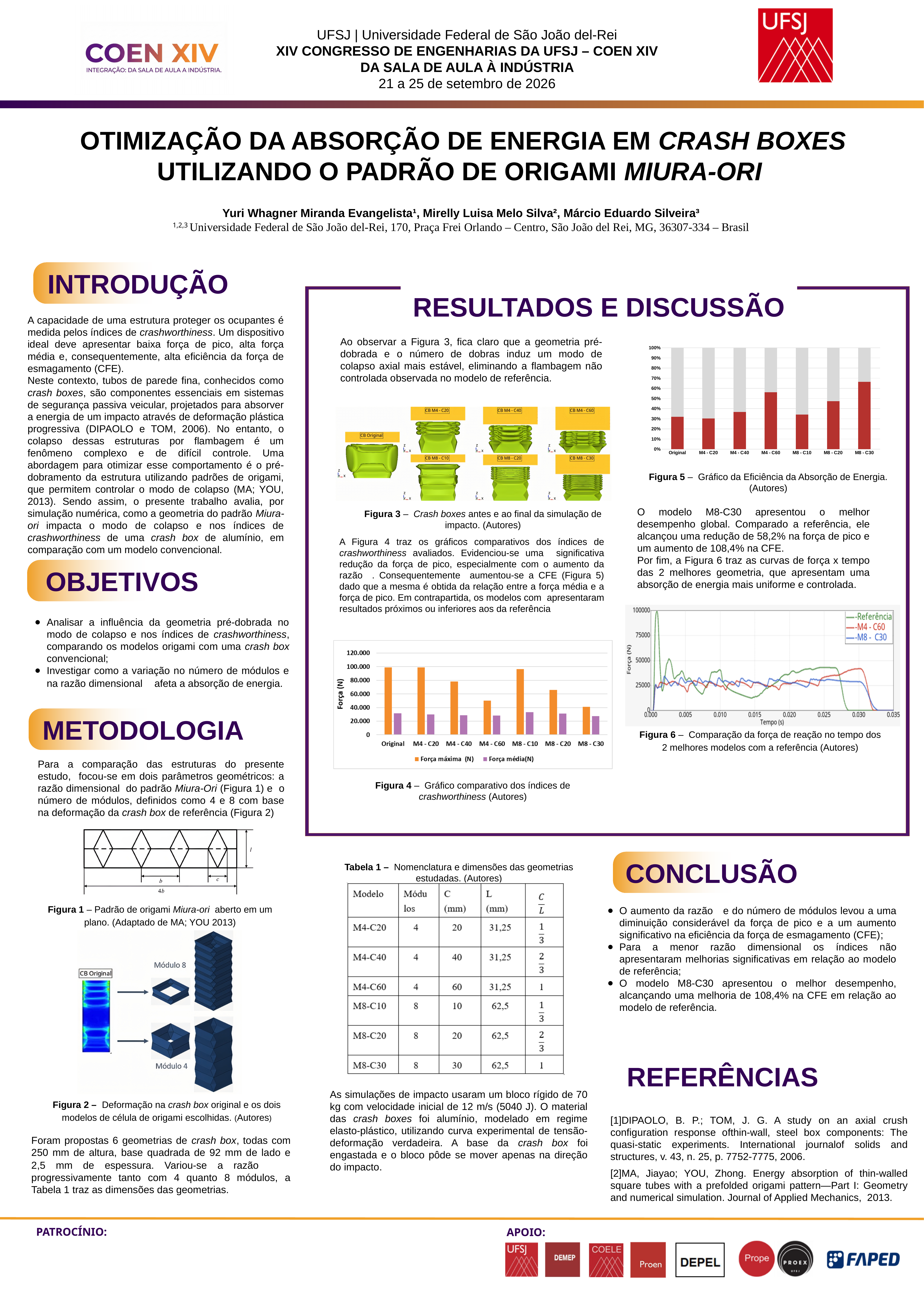
In Figura 5, is the red bar value for M8 - C30 greater or less than 60%? greater In Figura 4, how many series does the legend list? 2 In Figura 4, how many model categories are shown on the x axis? 7 In Figura 6 (Comparação da força de reação no tempo), how many series does the legend list? 3 In Figura 5, is the red bar value for M4 - C60 greater or less than 50%? greater In Figura 5 (Gráfico da Eficiência da Absorção de Energia), which model has the highest red bar value? M8 - C30 In Figura 4, which model has the lowest Força máxima (N)? M8 - C30 In Figura 6, what kind of chart is shown? line chart In Figura 4 (Gráfico comparativo dos índices de crashworthiness), what kind of chart is shown? bar chart In Figura 4, is the Força máxima (N) for M4 - C40 greater or less than 60.000? greater In Figura 4, which has the larger Força máxima (N): M4 - C40 or M8 - C20? M4 - C40